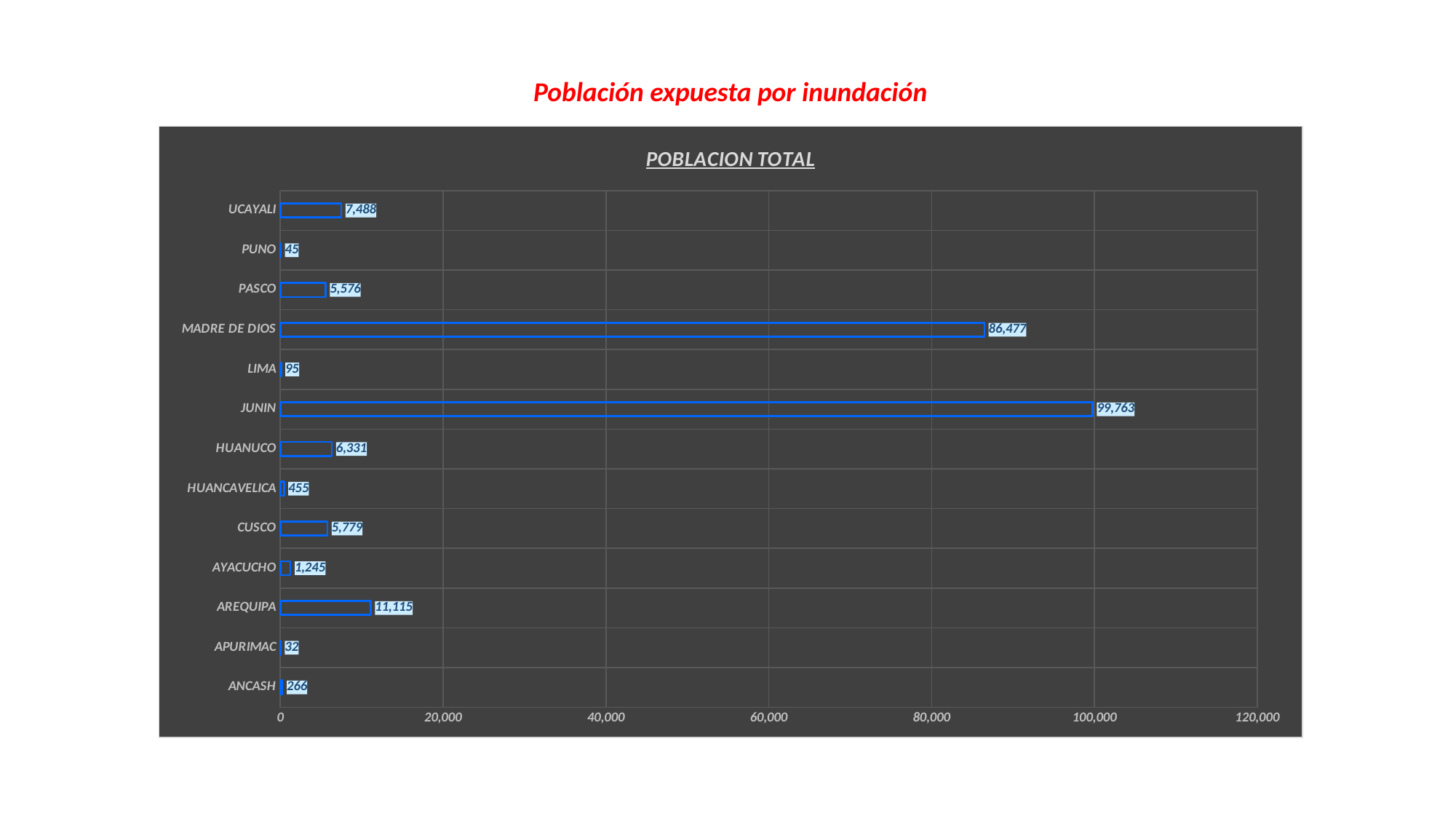
What kind of chart is this? bar chart What is the value for MADRE DE DIOS? 86,477 Which category has the highest value? JUNIN Which is larger, the value for CUSCO or the value for PASCO? CUSCO Is the value for MADRE DE DIOS greater or less than 80,000? greater What is the title of the chart? POBLACION TOTAL How many categories are shown in the chart? 13 What is the difference between the values for JUNIN and MADRE DE DIOS? 13,286 What is the value for JUNIN? 99,763 What is the value for AREQUIPA? 11,115 What is the value for HUANCAVELICA? 455 Which category has the lowest value? APURIMAC